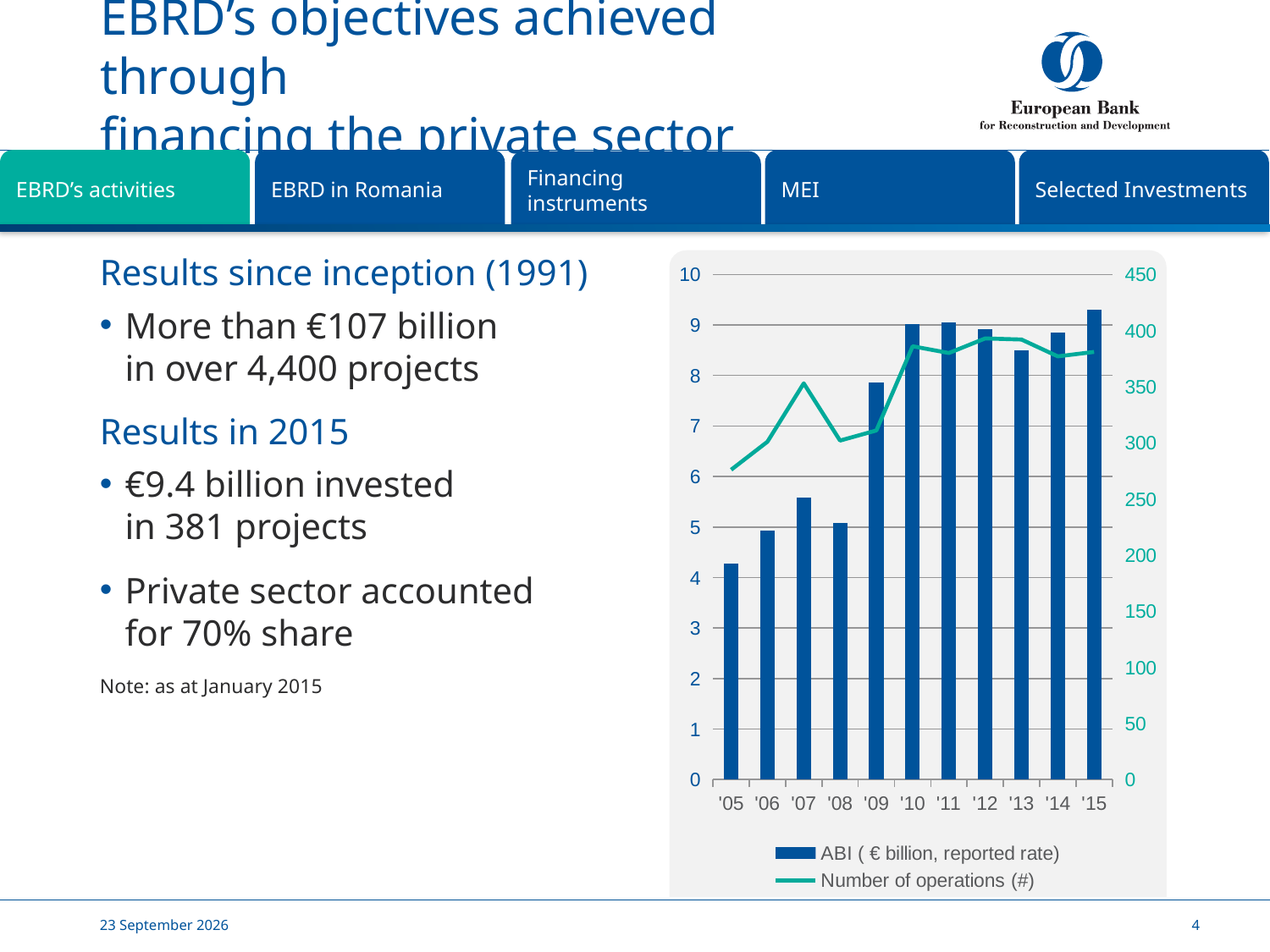
Is the number of operations for '07 greater or less than 300? greater Which year has a higher ABI bar, '07 or '08? '07 Which year has the lowest number of operations on the line? '05 Which year has the highest ABI bar? '15 Is the ABI value for '15 greater or less than 9? greater What does the blue bar series in the legend represent? ABI ( € billion, reported rate) Which year has the lowest ABI bar? '05 How many years are shown on the x axis of the chart? 11 Is the ABI value for '09 greater or less than 7? greater What kind of chart is shown on the slide? A combined bar and line chart How many series does the chart's legend list? 2